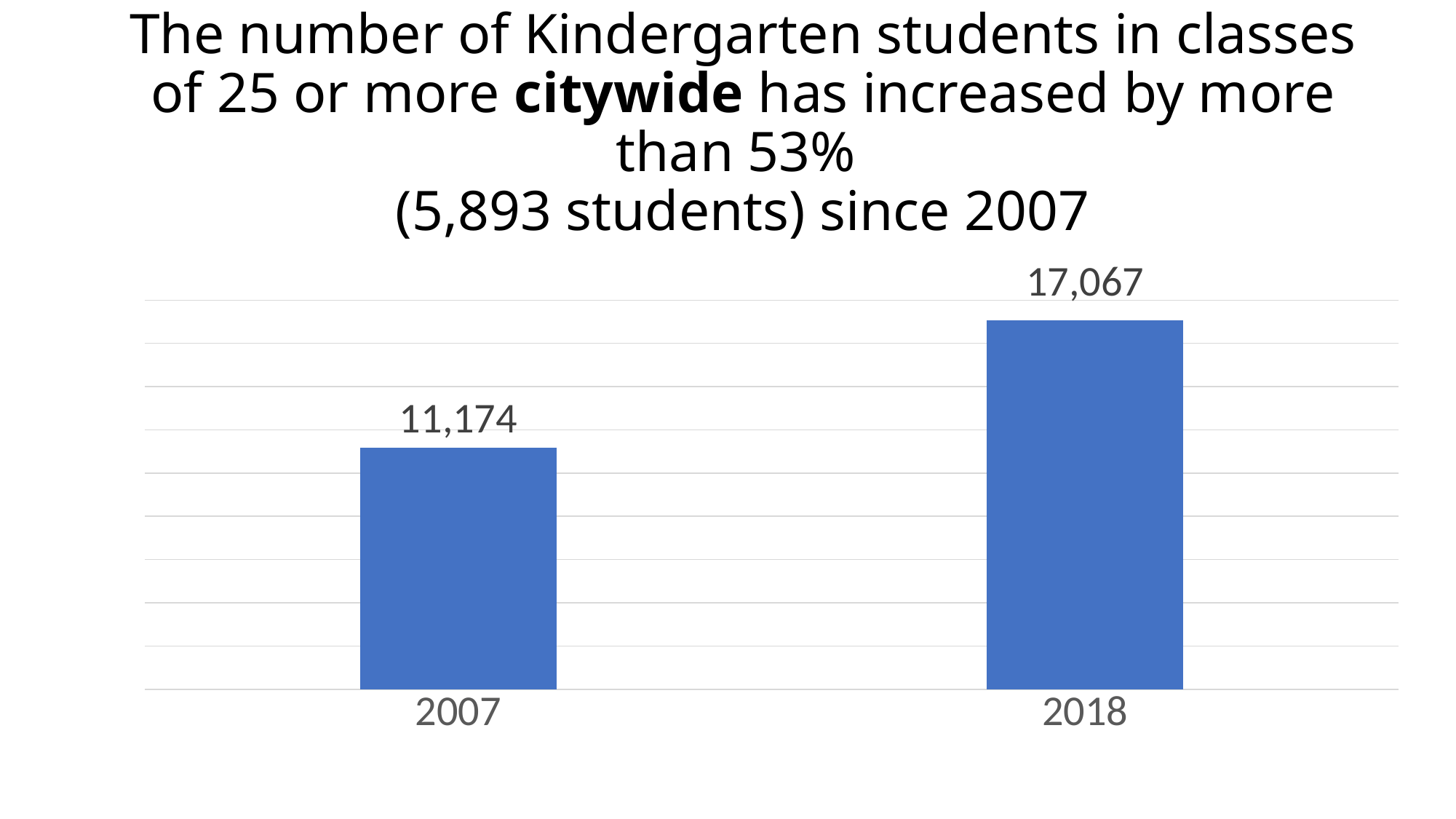
What is the total of the two bars shown? 28,241 What is the value for 2018? 17,067 Which is larger, the value for 2007 or the value for 2018? 2018 Which year has the highest value? 2018 According to the slide title, by what percentage has the number of Kindergarten students in classes of 25 or more citywide increased since 2007? more than 53% What colour are the bars in the chart? blue What is the difference between the values for 2018 and 2007? 5,893 What is the value for 2007? 11,174 What kind of chart is shown on the slide? bar chart How many bars are shown in the chart? 2 Do the values rise or fall from 2007 to 2018? rise Which year has the lowest value? 2007